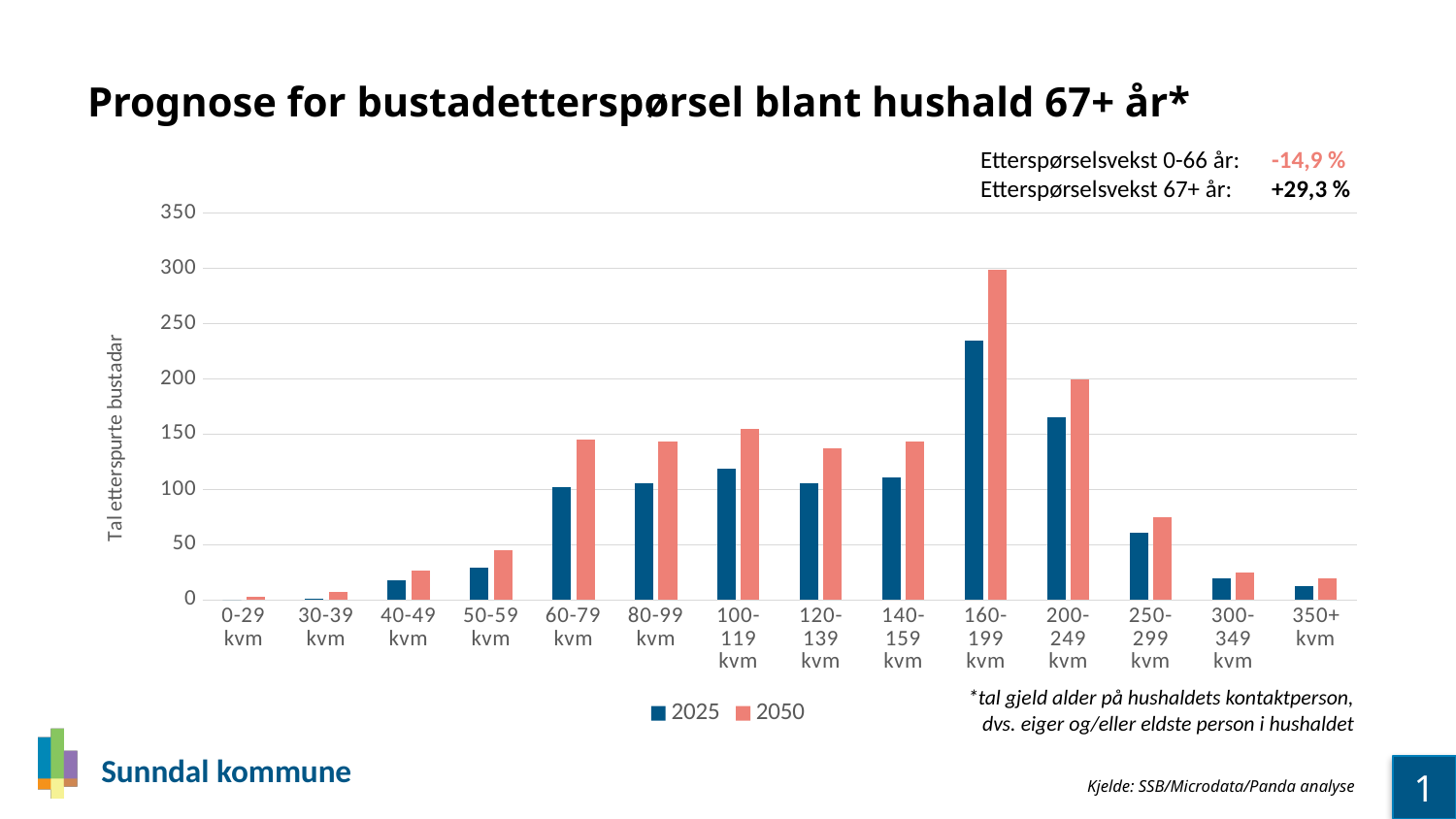
Is the 2025 value for 200-249 kvm greater or less than 150? greater For 160-199 kvm, which series has the larger value, 2025 or 2050? 2050 How many series does the legend list? 2 What is the label on the vertical axis? Tal etterspurte bustadar For the 2025 series, which is larger: 160-199 kvm or 200-249 kvm? 160-199 kvm Is the 2050 value for 250-299 kvm greater or less than 100? less Which size category has the highest value for the 2025 series? 160-199 kvm Is the 2050 value for 160-199 kvm greater or less than 250? greater How many size categories are shown on the x axis? 14 Which size category has the highest value for the 2050 series? 160-199 kvm What kind of chart is shown on the slide? bar chart